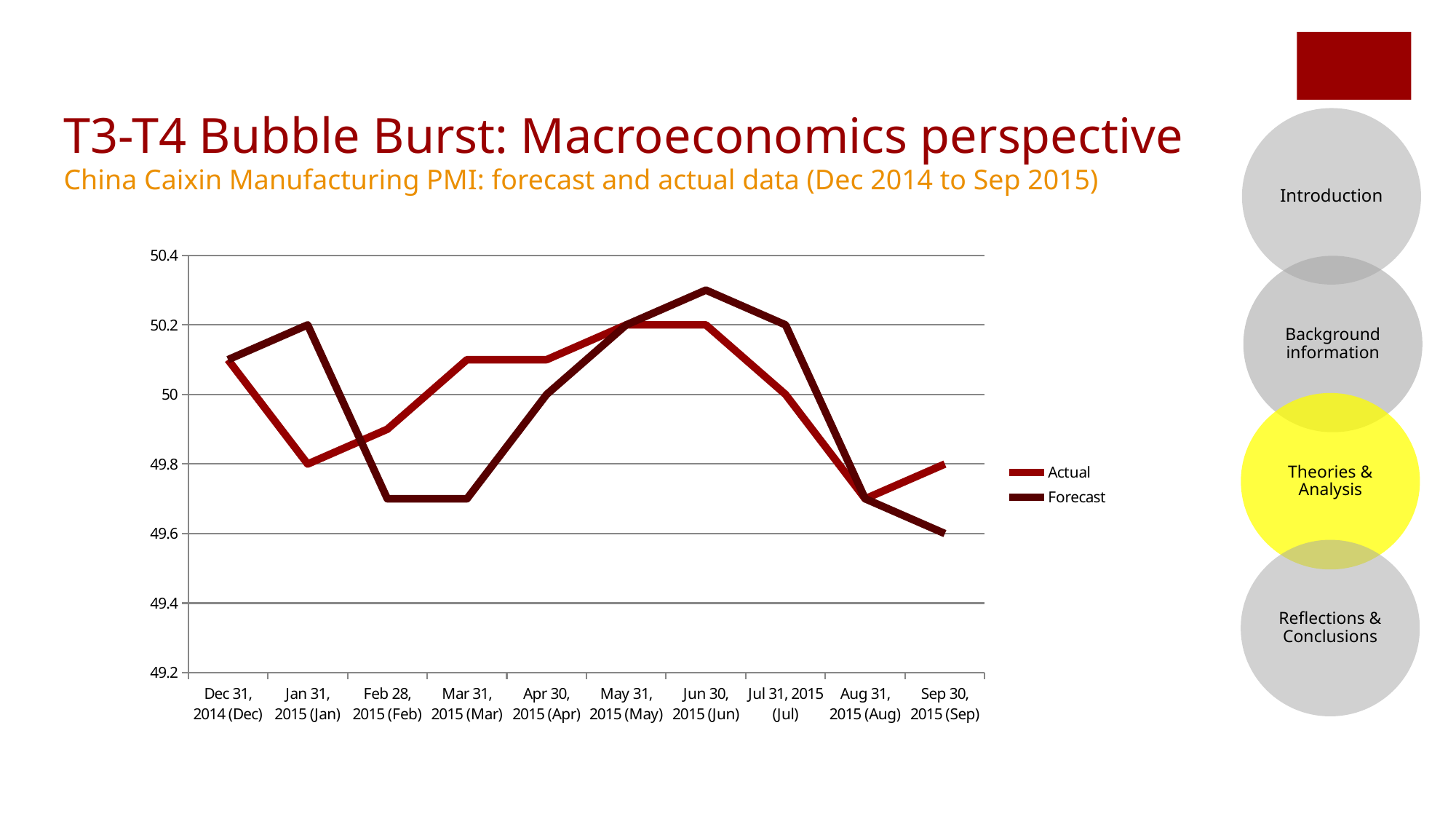
How many series does the legend list? 2 What kind of chart is shown on the slide? line chart What is the Forecast value for Sep 30, 2015 (Sep)? 49.6 At Sep 30, 2015 (Sep), which series is higher, Actual or Forecast? Actual Is the Actual value for Aug 31, 2015 (Aug) greater or less than 50? less At Jan 31, 2015 (Jan), which series is higher, Actual or Forecast? Forecast What is the Forecast value for Jan 31, 2015 (Jan)? 50.2 Is the Forecast value for Jun 30, 2015 (Jun) greater or less than 50.2? greater Does the Actual series rise or fall from Jun 30, 2015 (Jun) to Aug 31, 2015 (Aug)? fall What is the Actual value for Jan 31, 2015 (Jan)? 49.8 How many dates are plotted along the x axis? 10 On which date does the Forecast series reach its highest value? Jun 30, 2015 (Jun)